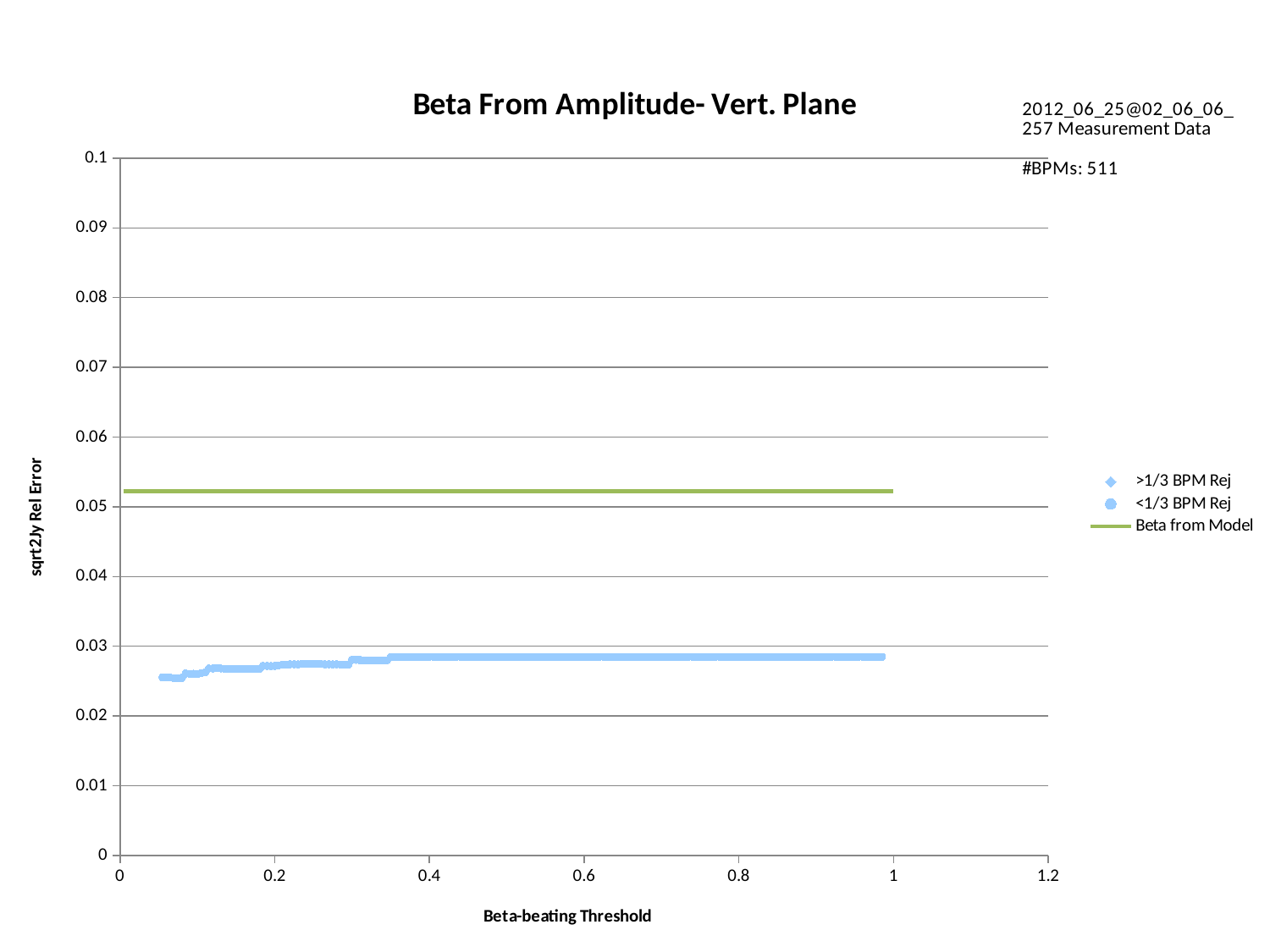
How many series does the legend list? 3 What is the highest tick value shown on the y axis? 0.1 What kind of chart is this? scatter chart How many BPMs are stated on the slide? 511 Which is larger, the Beta from Model line or the <1/3 BPM Rej series? Beta from Model What is the label of the y axis? sqrt2Jy Rel Error Do the <1/3 BPM Rej values rise or fall as the Beta-beating Threshold increases? rise What is the title of the chart? Beta From Amplitude- Vert. Plane Is the value of the <1/3 BPM Rej series at a Beta-beating Threshold of 0.8 greater or less than 0.03? less Is the value of the Beta from Model line greater or less than 0.06? less What is the highest tick value shown on the x axis? 1.2 Is the value of the Beta from Model line greater or less than 0.05? greater